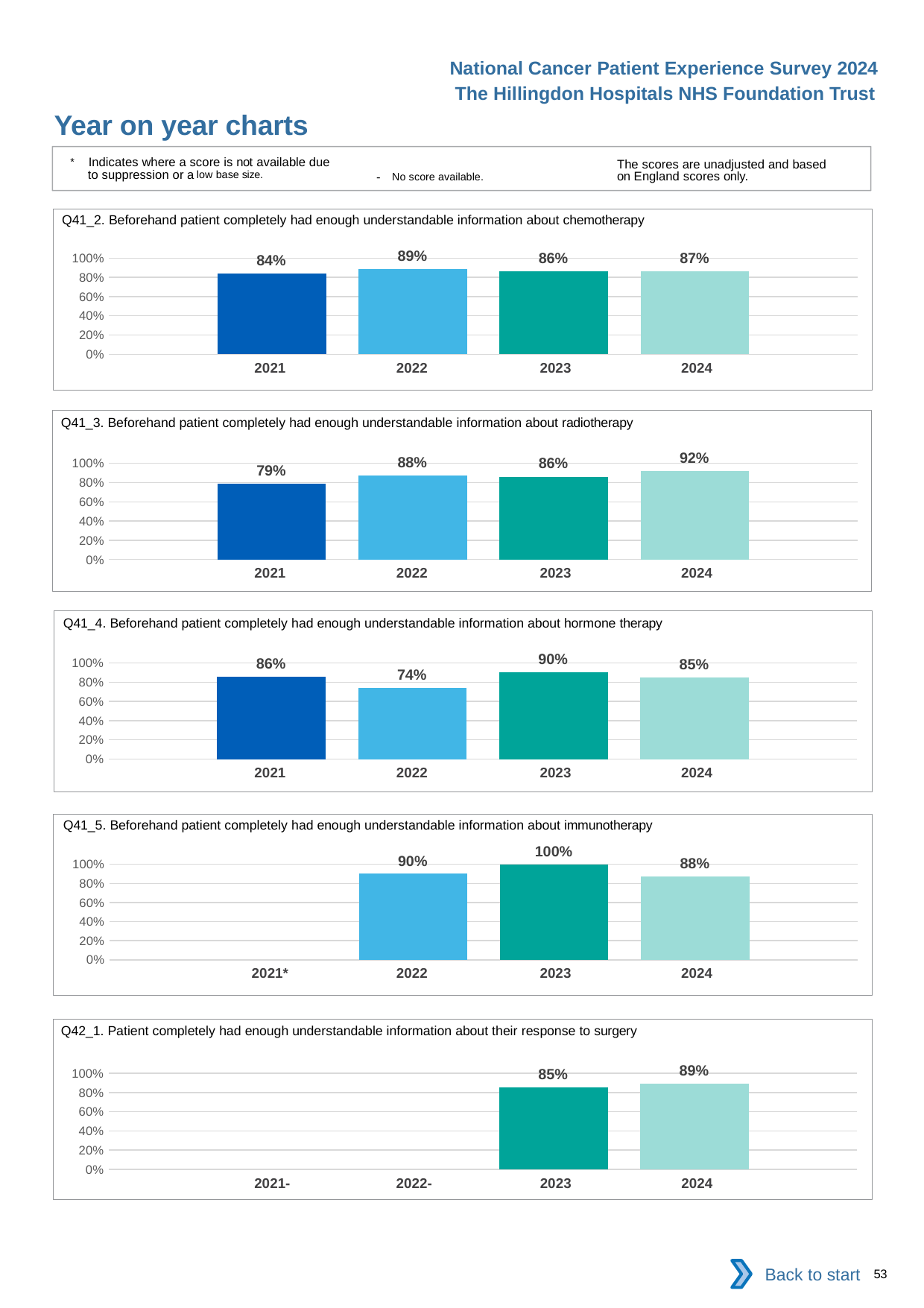
In the Q42_1 surgery chart, which is larger, the 2023 value or the 2024 value? 2024 In the Q41_3 radiotherapy chart, which year has the highest value? 2024 In the Q41_2 chemotherapy chart, what is the value for 2022? 89% What kind of chart is the Q41_2 chemotherapy chart? Bar chart In the Q41_5 immunotherapy chart, what is the value for 2023? 100% In the Q41_3 radiotherapy chart, what is the difference between the 2024 and 2021 values? 13 percentage points In the Q41_2 chemotherapy chart, is the value for 2021 greater or less than 80%? greater How many charts are shown on the slide? 5 In the Q41_4 hormone therapy chart, which year has the lowest value? 2022 In the Q41_5 immunotherapy chart, how many years have a bar plotted? 3 In the Q41_4 hormone therapy chart, what is the value for 2023? 90% In the Q42_1 surgery chart, what is the value for 2023? 85%